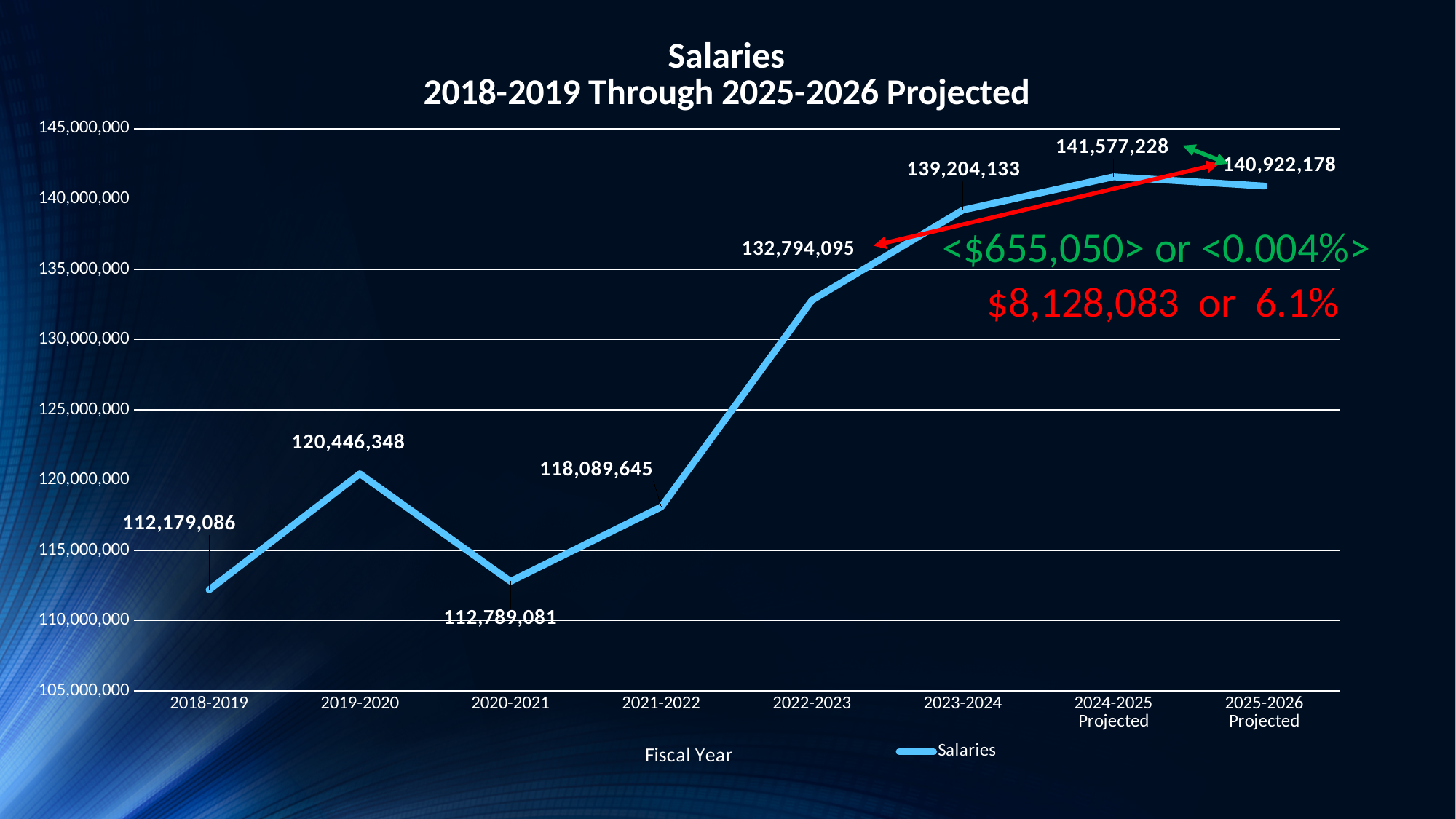
Which fiscal year has the lowest salaries value? 2018-2019 How many fiscal years are plotted on the chart? 8 Is the salaries value for 2022-2023 greater or less than 130,000,000? greater What is the projected salaries value for 2025-2026? 140,922,178 Which is larger, the salaries value for 2019-2020 or for 2021-2022? 2019-2020 Which fiscal year has the highest salaries value? 2024-2025 Projected What is the salaries value for 2022-2023? 132,794,095 What is the difference between the salaries for 2023-2024 and 2022-2023? 6,410,038 Do salaries rise or fall from 2019-2020 to 2020-2021? fall What kind of chart is shown on the slide? line chart What is the difference between the salaries for 2024-2025 Projected and 2025-2026 Projected? 655,050 What is the salaries value for 2020-2021? 112,789,081